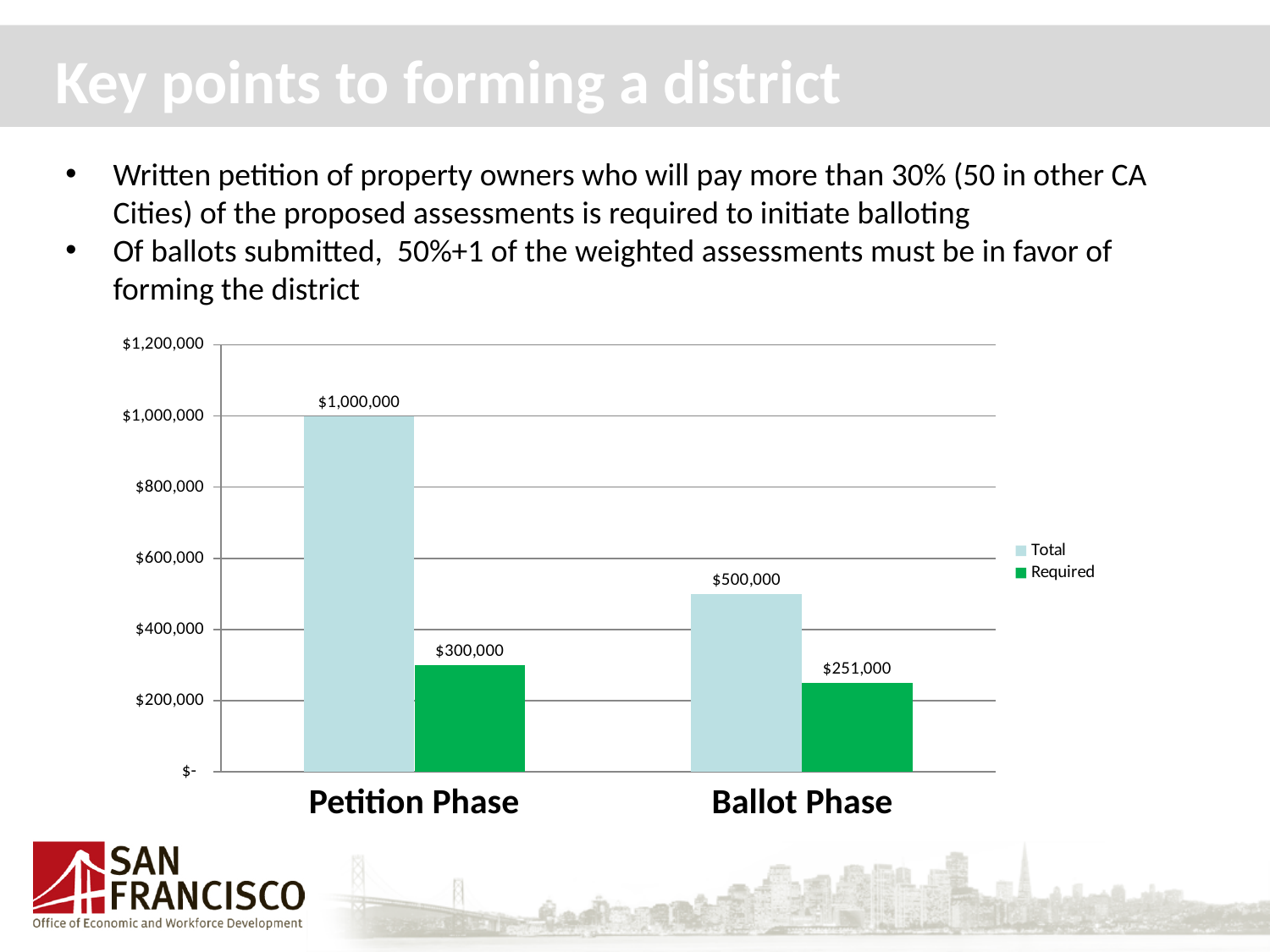
Which phase has the lowest Required value? Ballot Phase What is the Total value for the Ballot Phase? $500,000 What is the difference between the Total values for the Petition Phase and the Ballot Phase? $500,000 What is the difference between the Total and Required values for the Petition Phase? $700,000 What is the Total value for the Petition Phase? $1,000,000 What is the Required value for the Ballot Phase? $251,000 What kind of chart is shown on the slide? Bar chart How many series does the chart legend list? 2 How many categories are shown on the x axis of the chart? 2 Which is larger, the Required value for the Petition Phase or the Required value for the Ballot Phase? Petition Phase Which phase has the highest Total value? Petition Phase What is the Required value for the Petition Phase? $300,000